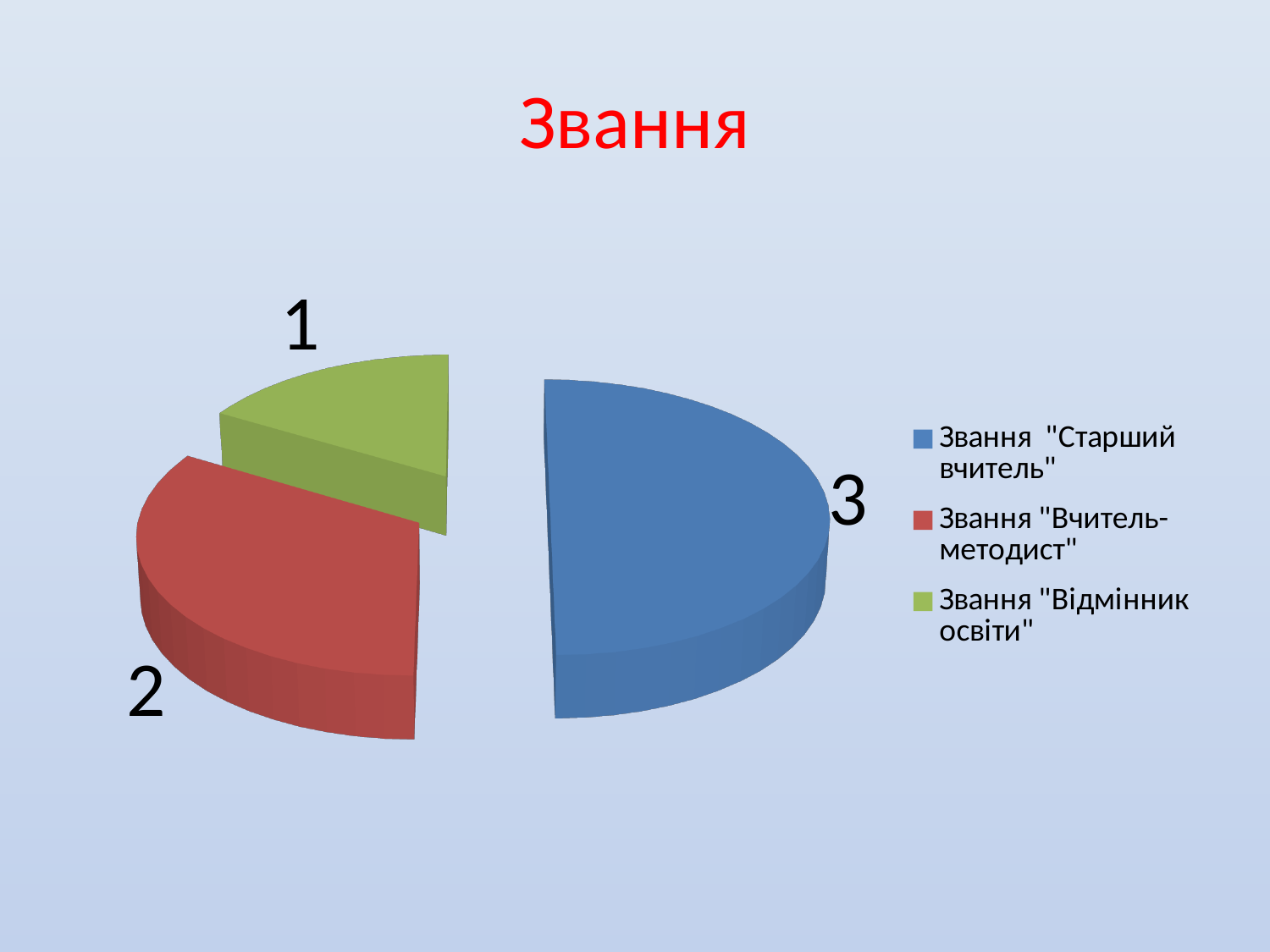
Which is larger, the value for Звання "Вчитель-методист" or Звання "Відмінник освіти"? Звання "Вчитель-методист" What share of the pie does Звання "Старший вчитель" represent? 50% What is the difference between the values for Звання "Старший вчитель" and Звання "Відмінник освіти"? 2 What is the title of the chart? Звання Which category has the smallest slice? Звання "Відмінник освіти" What is the value for Звання "Старший вчитель"? 3 How many slices does the pie chart have? 3 How many entries does the legend list? 3 What is the value for Звання "Вчитель-методист"? 2 What is the value for Звання "Відмінник освіти"? 1 What kind of chart is shown on the slide? Pie chart Which category has the largest slice? Звання "Старший вчитель"